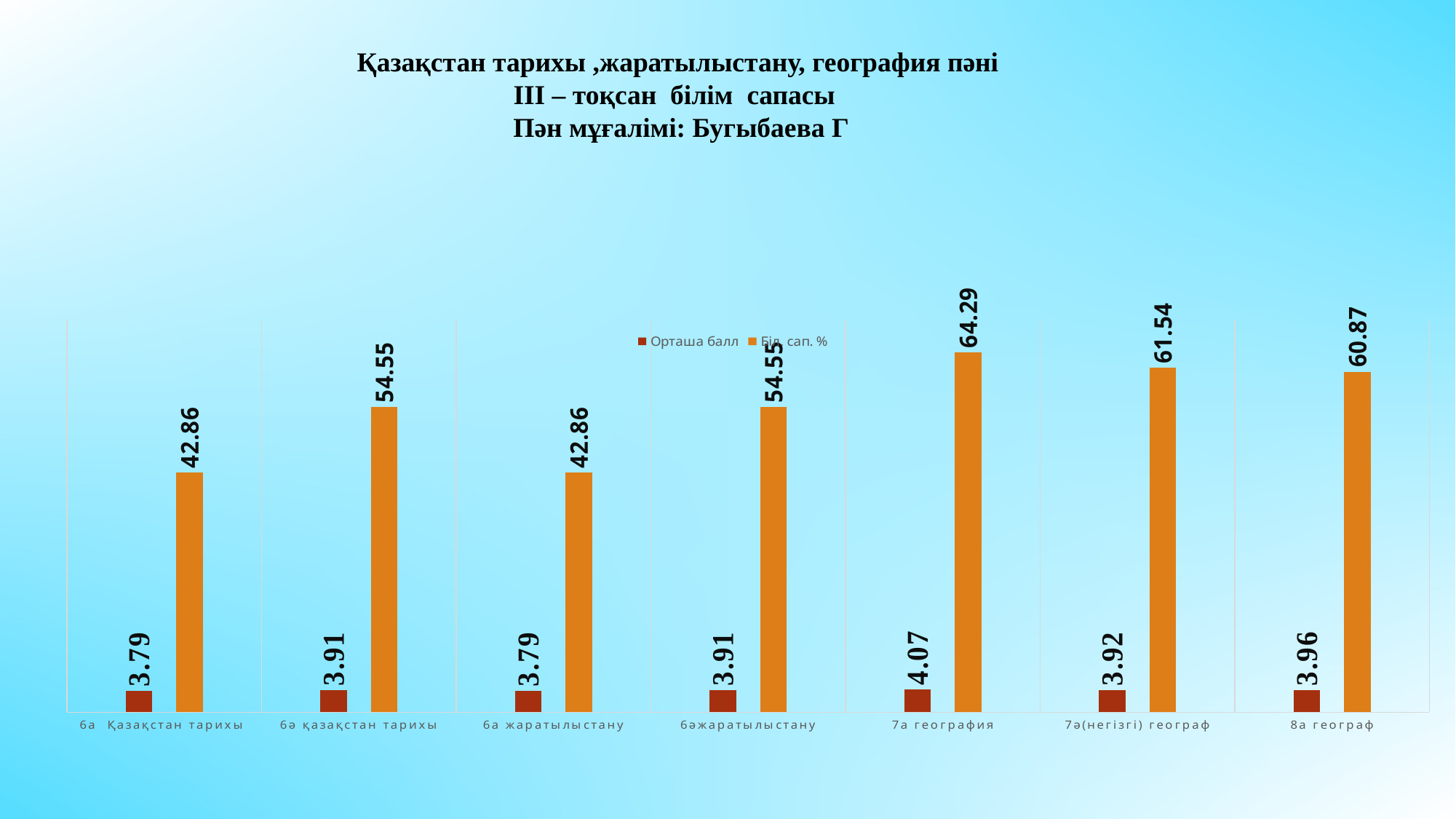
Which category has the highest Біл. сап. % value? 7а география What is the Біл. сап. % value for 6ә қазақстан тарихы? 54.55 What type of chart is shown on the slide? bar chart Which is larger, the Біл. сап. % value for 7ә(негізгі) географ or for 8а географ? 7ә(негізгі) географ What is the Орташа балл value for 6а жаратылыстану? 3.79 Which category has the highest Орташа балл value? 7а география What is the Орташа балл value for 7а география? 4.07 What is the Біл. сап. % value for 8а географ? 60.87 How many categories are shown on the x axis of the chart? 7 What is the difference between the Біл. сап. % values for 7а география and 6а Қазақстан тарихы? 21.43 Which series in the legend is shown in orange? Біл. сап. % How many series does the chart's legend list? 2